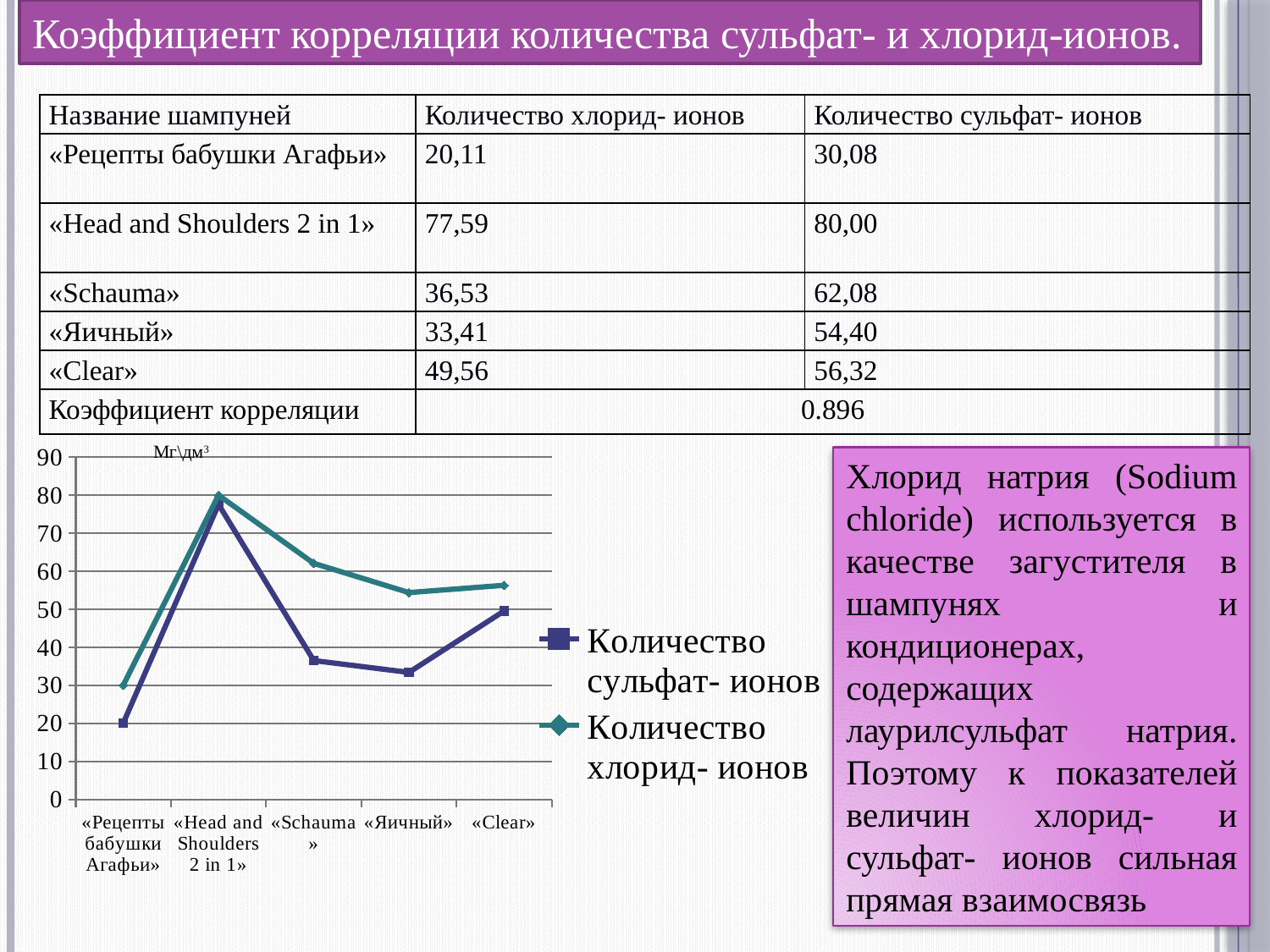
For which category does the series with square markers have its lowest value? «Рецепты бабушки Агафьи» What unit label is printed at the top of the chart's vertical axis? Мг\дм³ What kind of chart is shown on the slide? line chart How many shampoo categories are plotted along the x axis of the chart? 5 For which category does the series with diamond markers reach its highest value? «Head and Shoulders 2 in 1» At «Schauma», which series has the higher value: the one with square markers or the one with diamond markers? the one with diamond markers How many series does the chart legend list? 2 Is the value for «Рецепты бабушки Агафьи» in the series with square markers greater or less than 30? less Is the value for «Schauma» in the series with diamond markers greater or less than 50? greater Is the value for «Head and Shoulders 2 in 1» in the series with square markers greater or less than 70? greater Does the series with diamond markers rise or fall from «Head and Shoulders 2 in 1» to «Яичный»? fall Does the series with square markers rise or fall from «Рецепты бабушки Агафьи» to «Head and Shoulders 2 in 1»? rise